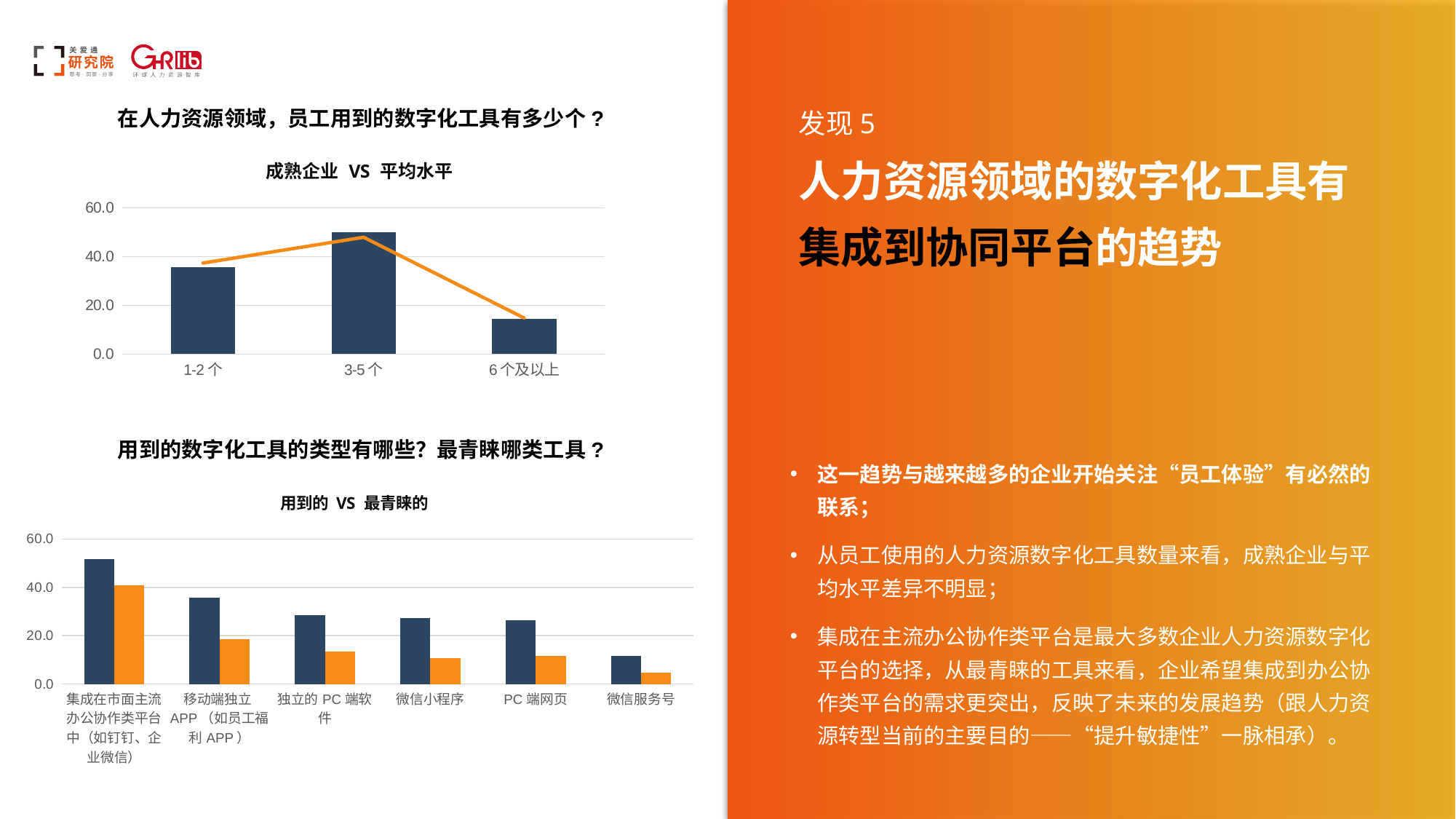
In the top chart titled 成熟企业 VS 平均水平, what kind of chart is it? bar chart with a line overlay In the top chart titled 成熟企业 VS 平均水平, is the bar for 3-5 个 greater or less than 40.0? greater In the top chart titled 成熟企业 VS 平均水平, is the bar for 6 个及以上 greater or less than 20.0? less In the bottom chart titled 用到的 VS 最青睐的, which category has the tallest dark blue bar? 集成在市面主流办公协作类平台中（如钉钉、企业微信） In the bottom chart titled 用到的 VS 最青睐的, which category has the shortest orange bar? 微信服务号 In the top chart titled 成熟企业 VS 平均水平, how many categories are shown on the x axis? 3 In the bottom chart titled 用到的 VS 最青睐的, which is larger: the dark blue bar for 移动端独立 APP or the dark blue bar for 微信服务号? 移动端独立 APP In the top chart titled 成熟企业 VS 平均水平, which category has the tallest bar? 3-5 个 In the top chart titled 成熟企业 VS 平均水平, which category has the shortest bar? 6 个及以上 In the bottom chart titled 用到的 VS 最青睐的, how many categories are shown on the x axis? 6 In the bottom chart titled 用到的 VS 最青睐的, what kind of chart is it? bar chart